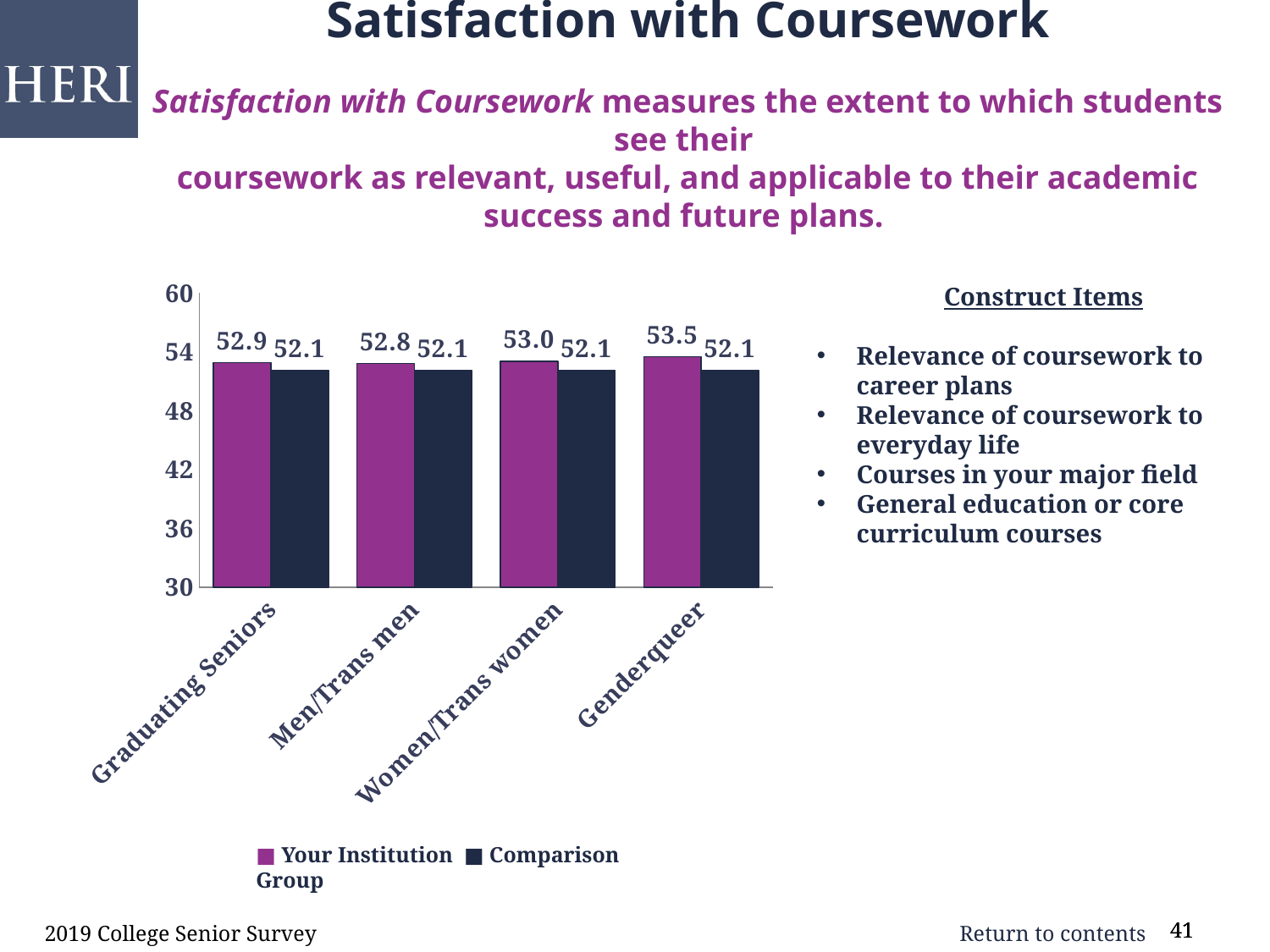
What is the Your Institution value for Women/Trans women? 53.0 Is the Your Institution value for Genderqueer greater or less than 48? greater Which category has the lowest Your Institution value? Men/Trans men What is the difference between the Your Institution values for Genderqueer and Men/Trans men? 0.7 Which series is shown in purple in the legend? Your Institution What is the difference between the Your Institution and Comparison Group values for Genderqueer? 1.4 What is the Your Institution value for Graduating Seniors? 52.9 What is the Comparison Group value for Genderqueer? 52.1 How many series does the legend list? 2 How many categories are shown on the x axis? 4 What kind of chart is shown on the slide? bar chart Which category has the highest Your Institution value? Genderqueer